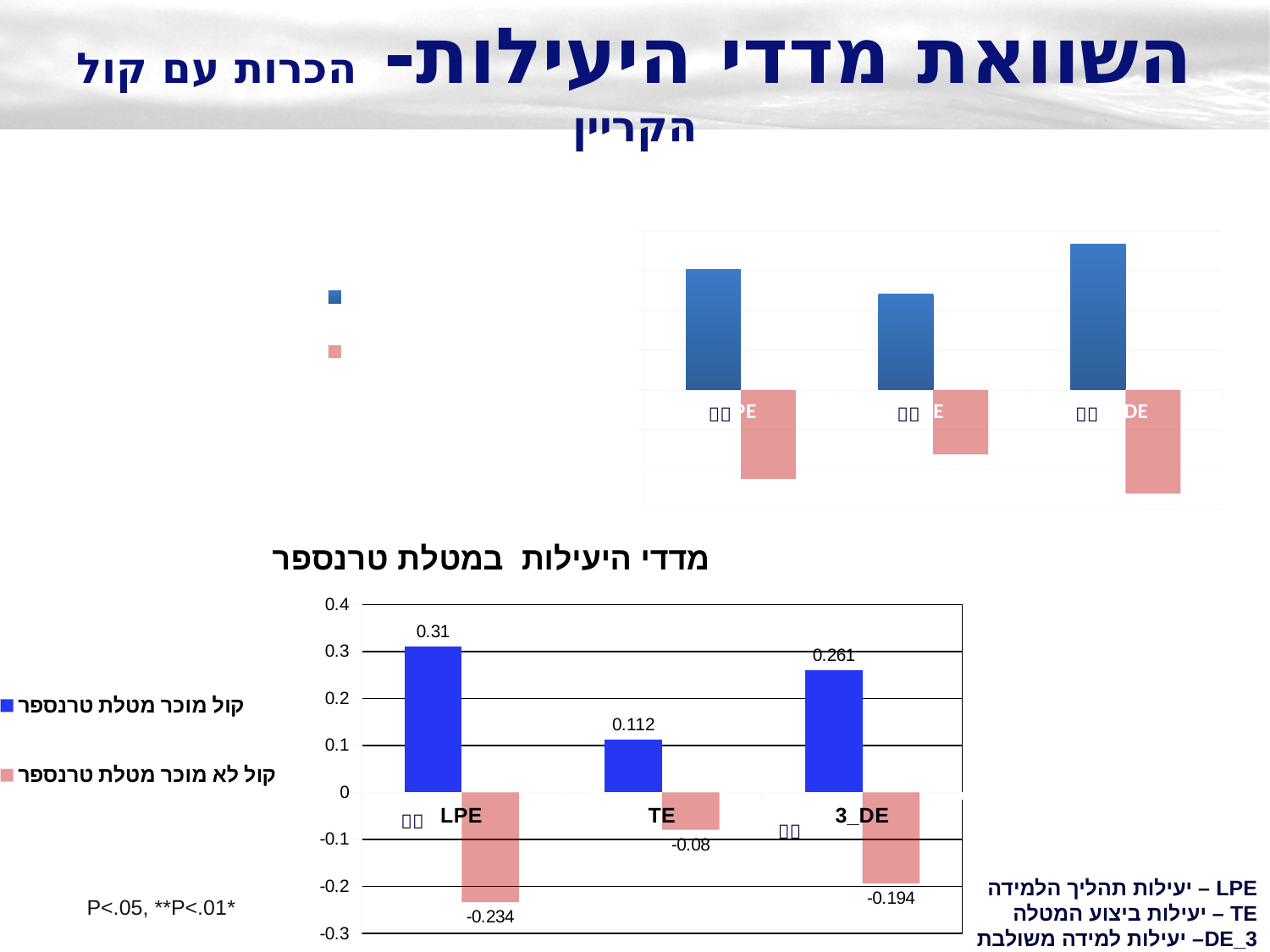
In the chart titled 'מדדי היעילות במטלת טרנספר', what is the value for TE in the 'קול לא מוכר מטלת טרנספר' series? -0.08 What kind of chart is the one titled 'מדדי היעילות במטלת טרנספר'? Bar chart In the chart titled 'מדדי היעילות במטלת טרנספר', what is the difference between the 'קול מוכר מטלת טרנספר' values for LPE and TE? 0.198 In the chart titled 'מדדי היעילות במטלת טרנספר', what is the value for LPE in the 'קול לא מוכר מטלת טרנספר' series? -0.234 In the chart titled 'מדדי היעילות במטלת טרנספר', what is the value for 3_DE in the 'קול מוכר מטלת טרנספר' series? 0.261 In the chart titled 'מדדי היעילות במטלת טרנספר', which category has the highest value in the 'קול מוכר מטלת טרנספר' series? LPE In the chart titled 'מדדי היעילות במטלת טרנספר', what is the value for LPE in the 'קול מוכר מטלת טרנספר' series? 0.31 In the chart titled 'מדדי היעילות במטלת טרנספר', how many categories are shown on the x axis? 3 In the chart titled 'מדדי היעילות במטלת טרנספר', which category has the lowest value in the 'קול מוכר מטלת טרנספר' series? TE In the chart titled 'מדדי היעילות במטלת טרנספר', which is larger in the 'קול מוכר מטלת טרנספר' series: TE or 3_DE? 3_DE In the chart titled 'מדדי היעילות במטלת טרנספר', what colour are the bars for the 'קול לא מוכר מטלת טרנספר' series? Pink In the chart titled 'מדדי היעילות במטלת טרנספר', how many series does the legend list? 2